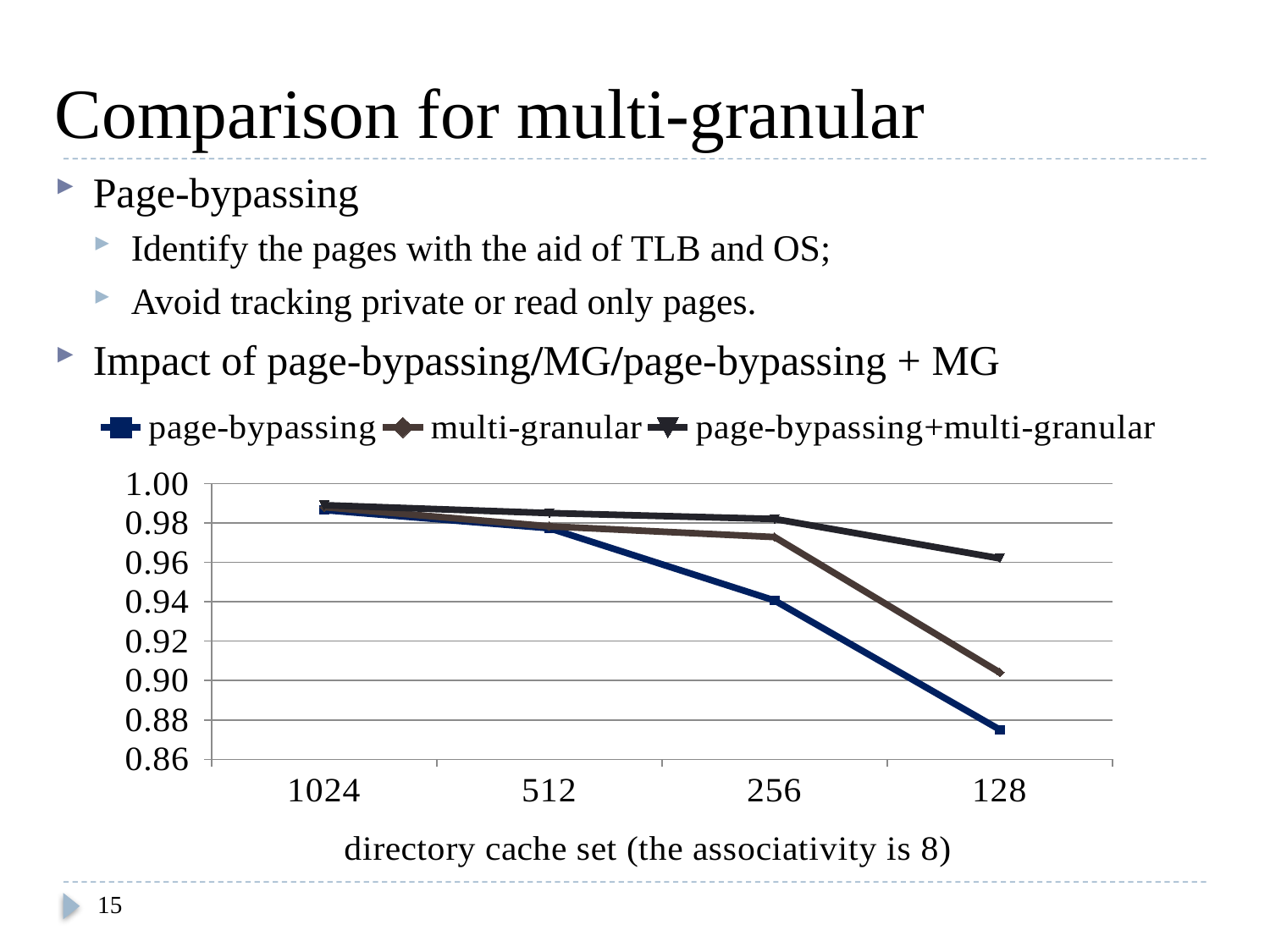
At a directory cache set of 256, which is larger: multi-granular or page-bypassing? multi-granular Do the values for page-bypassing rise or fall as the directory cache set goes from 1024 to 128? fall What is the x-axis title of the chart? directory cache set (the associativity is 8) Which series has the highest value at a directory cache set of 128? page-bypassing+multi-granular Is the value for page-bypassing+multi-granular at 128 greater or less than 0.94? greater Is the value for page-bypassing at 256 greater or less than 0.96? less How many series does the legend list? 3 What kind of chart is shown on the slide? line chart Is the value for page-bypassing at 128 greater or less than 0.90? less Which series has the lowest value at a directory cache set of 128? page-bypassing How many directory cache set sizes are plotted along the x axis? 4